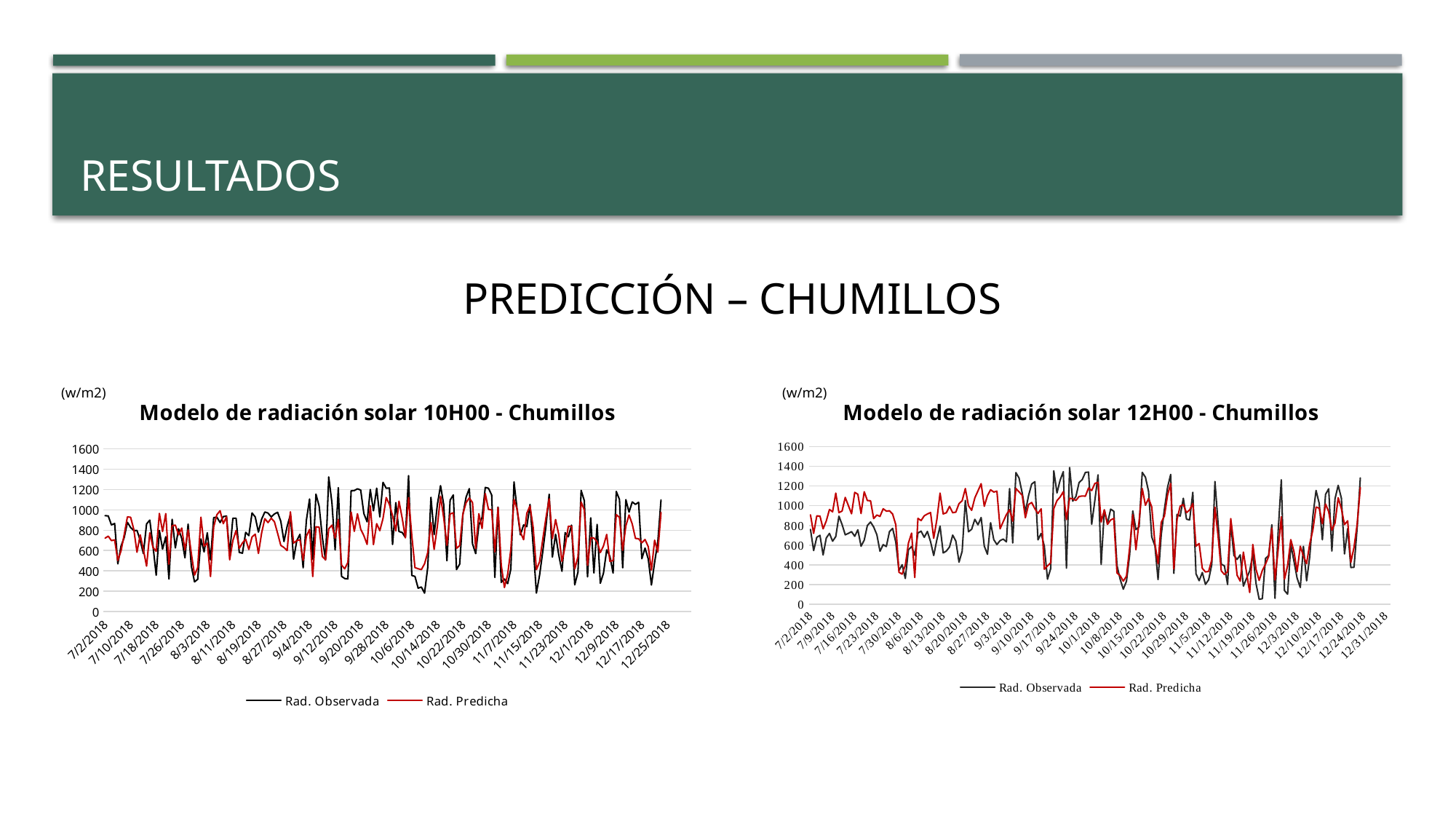
In the 'Modelo de radiación solar 12H00 - Chumillos' chart, is the value of Rad. Observada on 7/2/2018 greater or less than 400? greater In the 'Modelo de radiación solar 12H00 - Chumillos' chart, is the value of Rad. Predicha on 7/16/2018 greater or less than 800? greater In the 'Modelo de radiación solar 12H00 - Chumillos' chart, which series is drawn in red? Rad. Predicha How many series does the legend of the 'Modelo de radiación solar 12H00 - Chumillos' chart list? 2 In the 'Modelo de radiación solar 10H00 - Chumillos' chart, is the highest value of Rad. Observada greater or less than 1200? greater How many series does the legend of the 'Modelo de radiación solar 10H00 - Chumillos' chart list? 2 What kind of chart is the 'Modelo de radiación solar 12H00 - Chumillos' chart? line chart What kind of chart is the 'Modelo de radiación solar 10H00 - Chumillos' chart? line chart What unit is shown above the y axis of the 'Modelo de radiación solar 10H00 - Chumillos' chart? (w/m2)